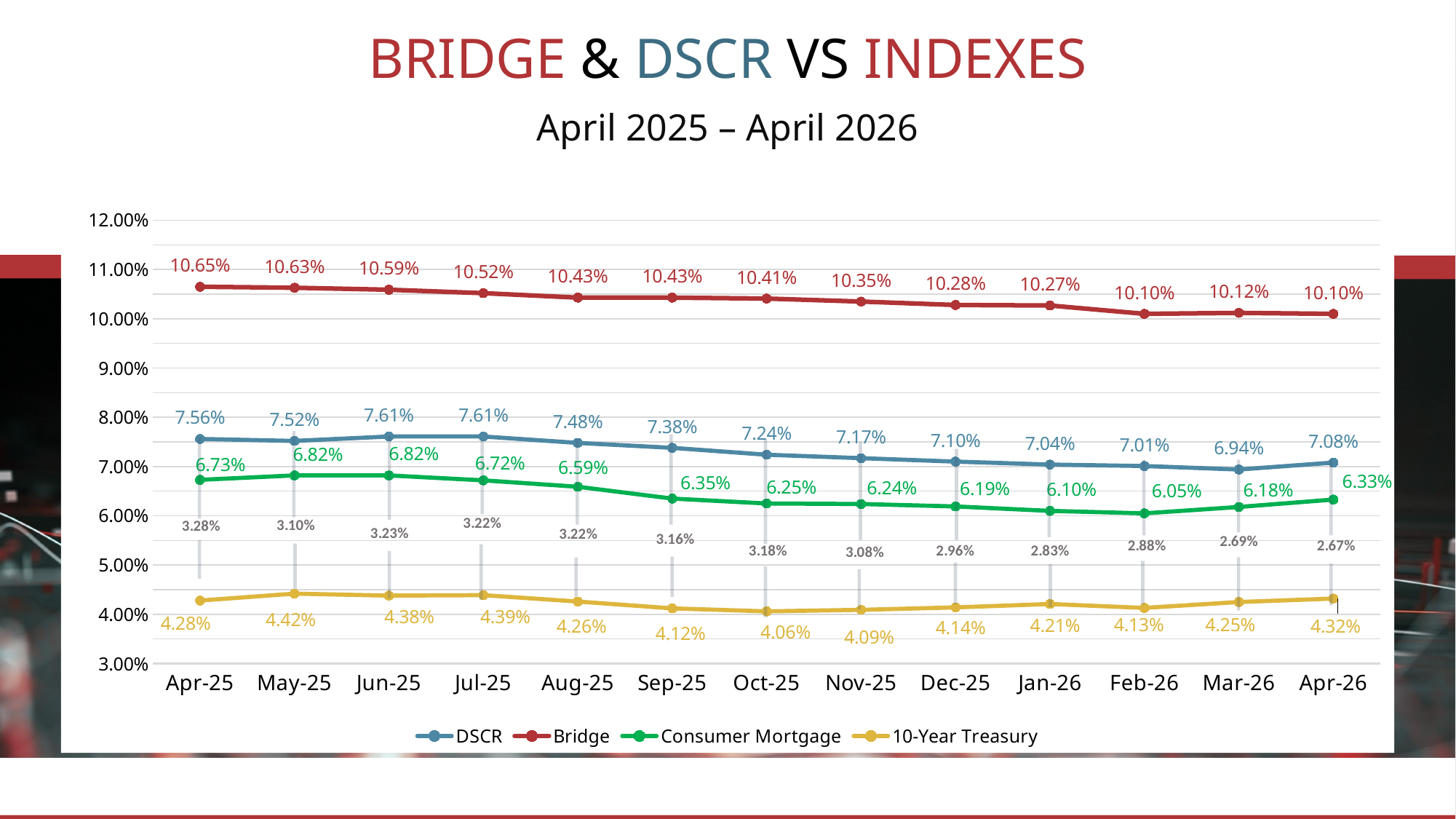
What is the Consumer Mortgage value for Feb-26? 6.05% How many series does the legend list? 4 Does the Bridge series generally rise or fall from Apr-25 to Apr-26? Fall What is the Bridge value for Apr-25? 10.65% What is the DSCR value for Jul-25? 7.61% What is the 10-Year Treasury value for Oct-25? 4.06% How many months are plotted on the x axis? 13 What is the difference between the Bridge value and the DSCR value in Apr-26? 3.02% Which is larger in Sep-25, the Consumer Mortgage value or the 10-Year Treasury value? Consumer Mortgage What type of chart is shown on the slide? Line chart In which month is the DSCR value lowest? Mar-26 In which month is the 10-Year Treasury value lowest? Oct-25